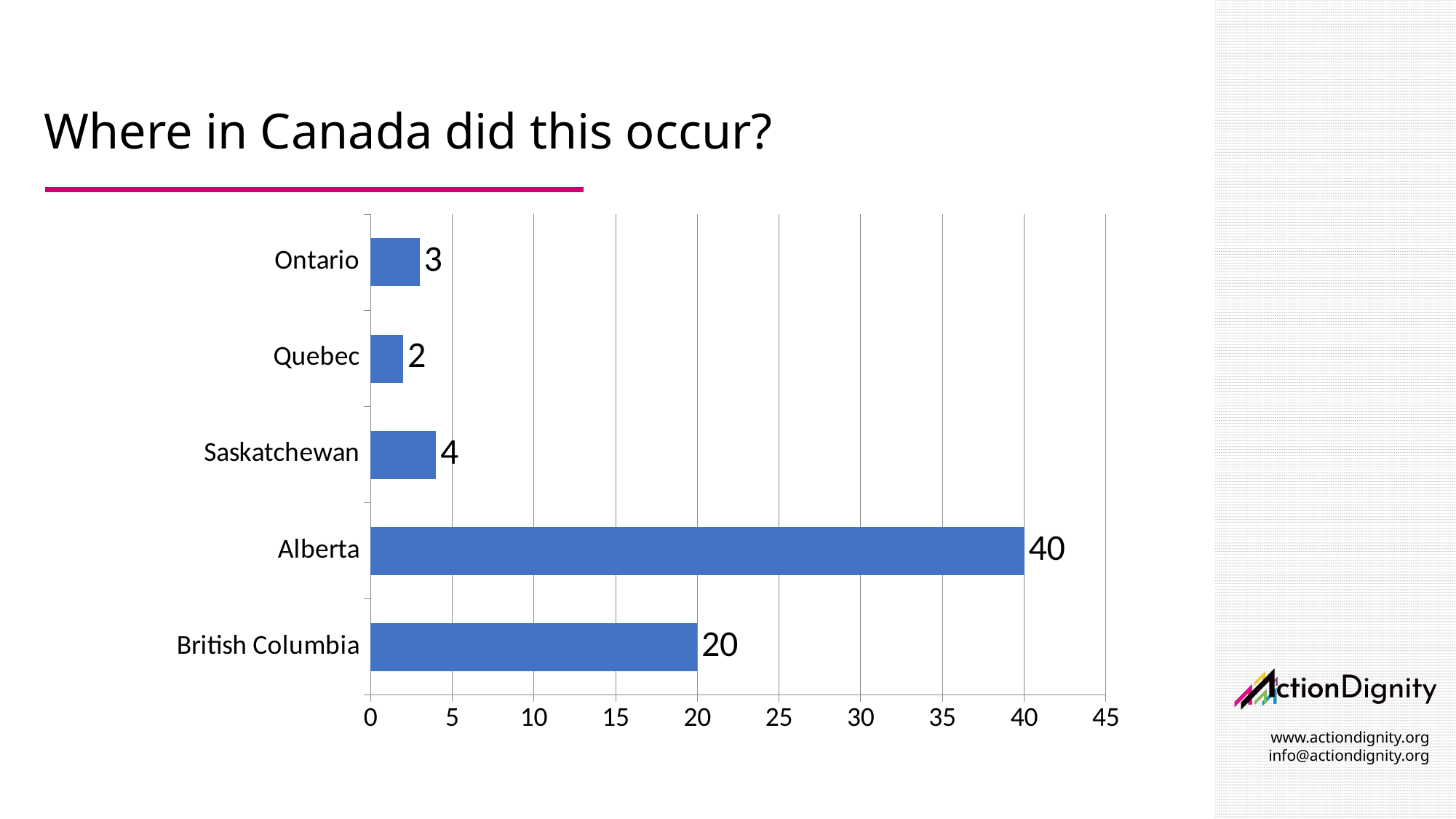
Which category has the highest value? Alberta How many categories are shown in the chart? 5 What is the value for Saskatchewan? 4 What is the difference between the values for Alberta and British Columbia? 20 What is the value for British Columbia? 20 What is the value for Quebec? 2 Which is larger, the value for Ontario or the value for Saskatchewan? Saskatchewan What is the value for Alberta? 40 Which category has the lowest value? Quebec What kind of chart is shown on the slide? bar chart Is the value for British Columbia greater or less than 15? greater What is the title of the slide? Where in Canada did this occur?